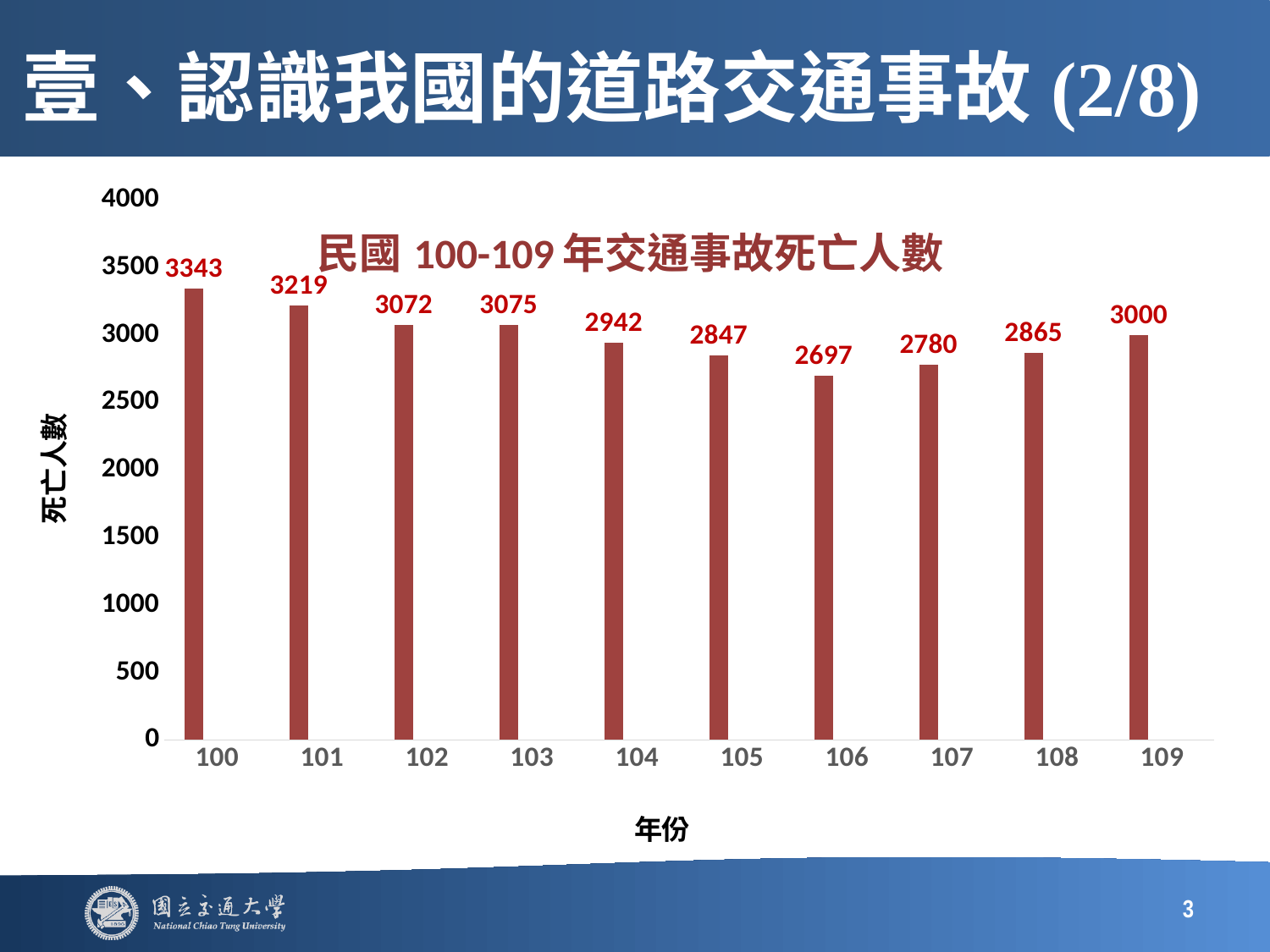
Which year has the lowest number of traffic accident deaths? 106 How many years are shown on the x axis of the chart? 10 Which year has more traffic accident deaths, 101 or 104? 101 What kind of chart is shown on the slide? bar chart What is the number of traffic accident deaths in year 109? 3000 Is the value for year 105 greater or less than 3000? less What is the difference in deaths between year 100 and year 106? 646 What is the number of traffic accident deaths in year 106? 2697 What is the number of traffic accident deaths in year 100? 3343 What is the difference in deaths between year 108 and year 107? 85 What is the title of the chart? 民國 100-109 年交通事故死亡人數 Which year has the highest number of traffic accident deaths? 100